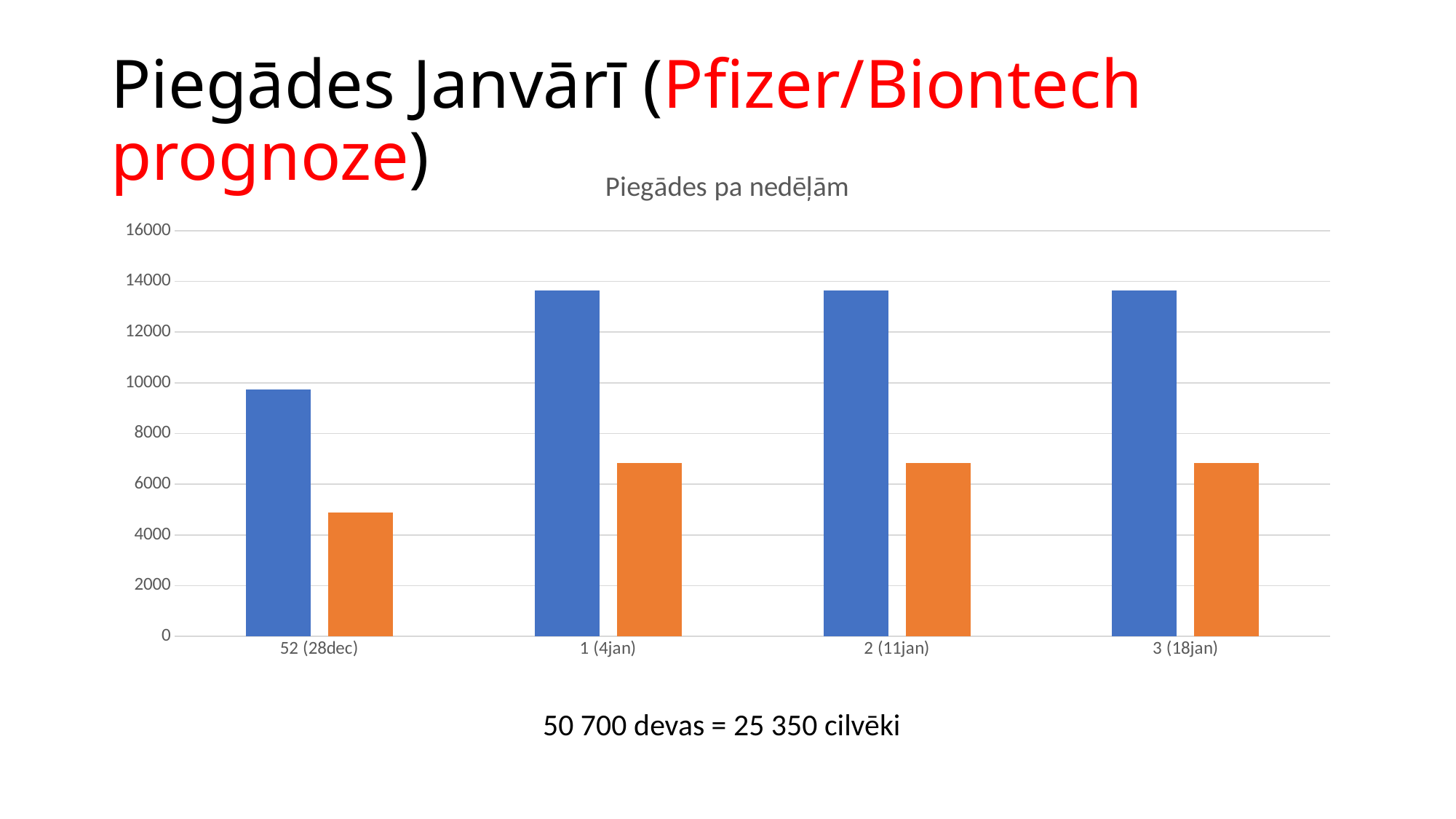
What is the title of the chart? Piegādes pa nedēļām Which category has a higher blue bar, 52 (28dec) or 1 (4jan)? 1 (4jan) Is the value of the blue bar for 52 (28dec) greater or less than 8000? greater Is the value of the blue bar for 1 (4jan) greater or less than 12000? greater How many differently coloured bar series are plotted for each category? 2 How many categories are shown on the x axis of the chart? 4 Is the value of the orange bar for 2 (11jan) greater or less than 6000? greater For 3 (18jan), which bar is larger, the blue one or the orange one? the blue one What kind of chart is shown on the slide? bar chart Do the blue bars rise or fall from 52 (28dec) to 1 (4jan)? rise Which category has the lowest blue bar? 52 (28dec)